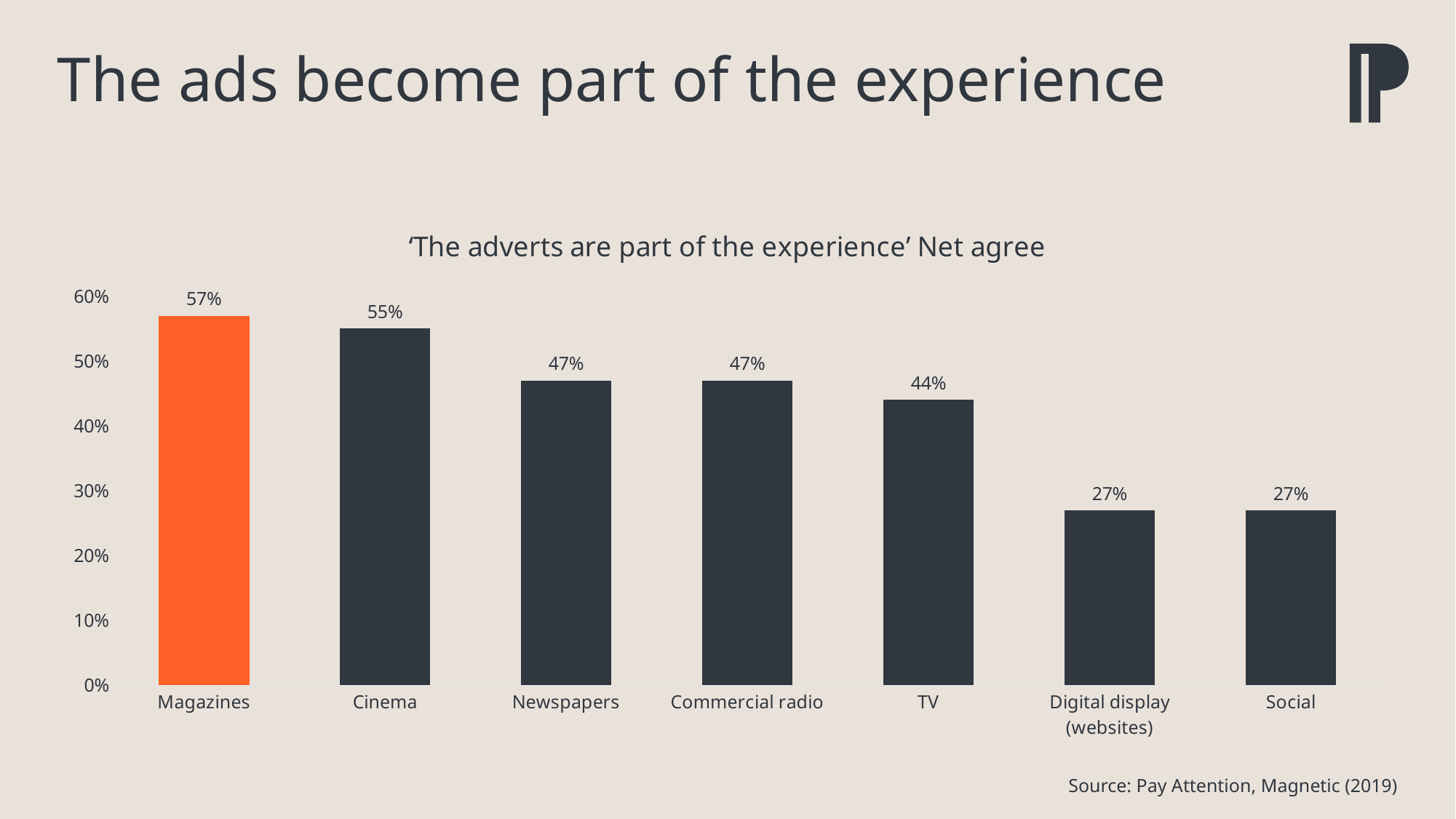
Which is larger, the value for Newspapers or the value for TV? Newspapers Is the value for Commercial radio greater or less than 40%? greater Which category has the highest value? Magazines What is the title of the chart? ‘The adverts are part of the experience’ Net agree What is the value for Magazines? 57% What is the value for TV? 44% What is the value for Digital display (websites)? 27% How many categories are shown in the chart? 7 What is the value for Cinema? 55% What is the difference between the values for Cinema and TV? 11% What is the difference between the values for Magazines and Social? 30% What kind of chart is shown on the slide? Bar chart